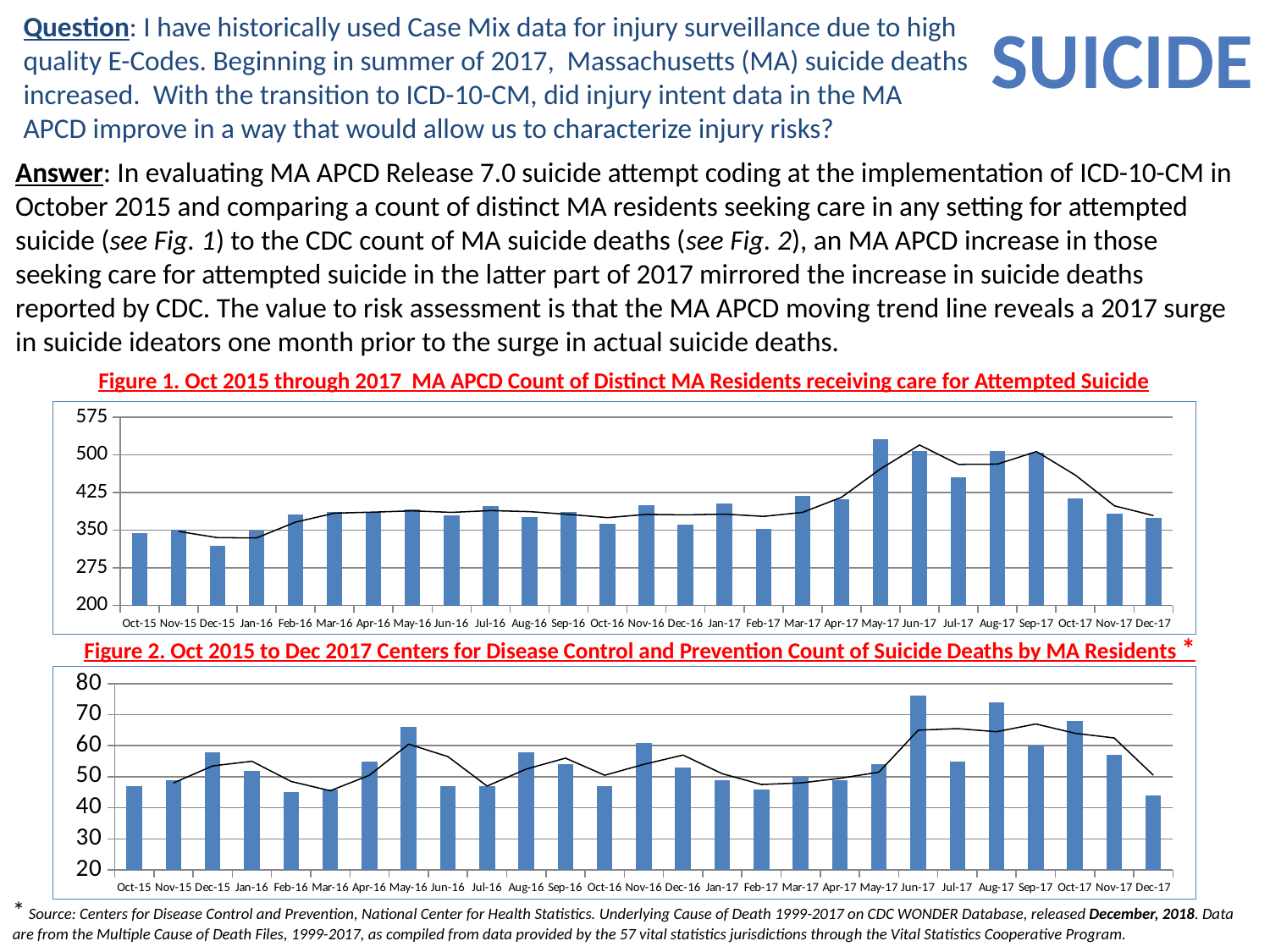
What kind of chart is Figure 2? Bar chart with a trend line In Figure 1, which month has the lowest bar? Dec-15 In Figure 1, which month has the highest count of distinct MA residents receiving care for attempted suicide? May-17 In Figure 2, is the value for Dec-17 greater or less than 50? less In Figure 1, which is larger, the value for May-17 or the value for Jan-16? May-17 In Figure 2, is the value for Jun-17 greater or less than 70? greater What is the first month shown on the x axis of Figure 2? Oct-15 In Figure 2, which month has the highest count of suicide deaths? Jun-17 How many months are plotted along the x axis of Figure 1? 27 In Figure 1, is the value for Dec-15 greater or less than 350? less In Figure 2, which is larger, the value for Aug-17 or the value for Feb-17? Aug-17